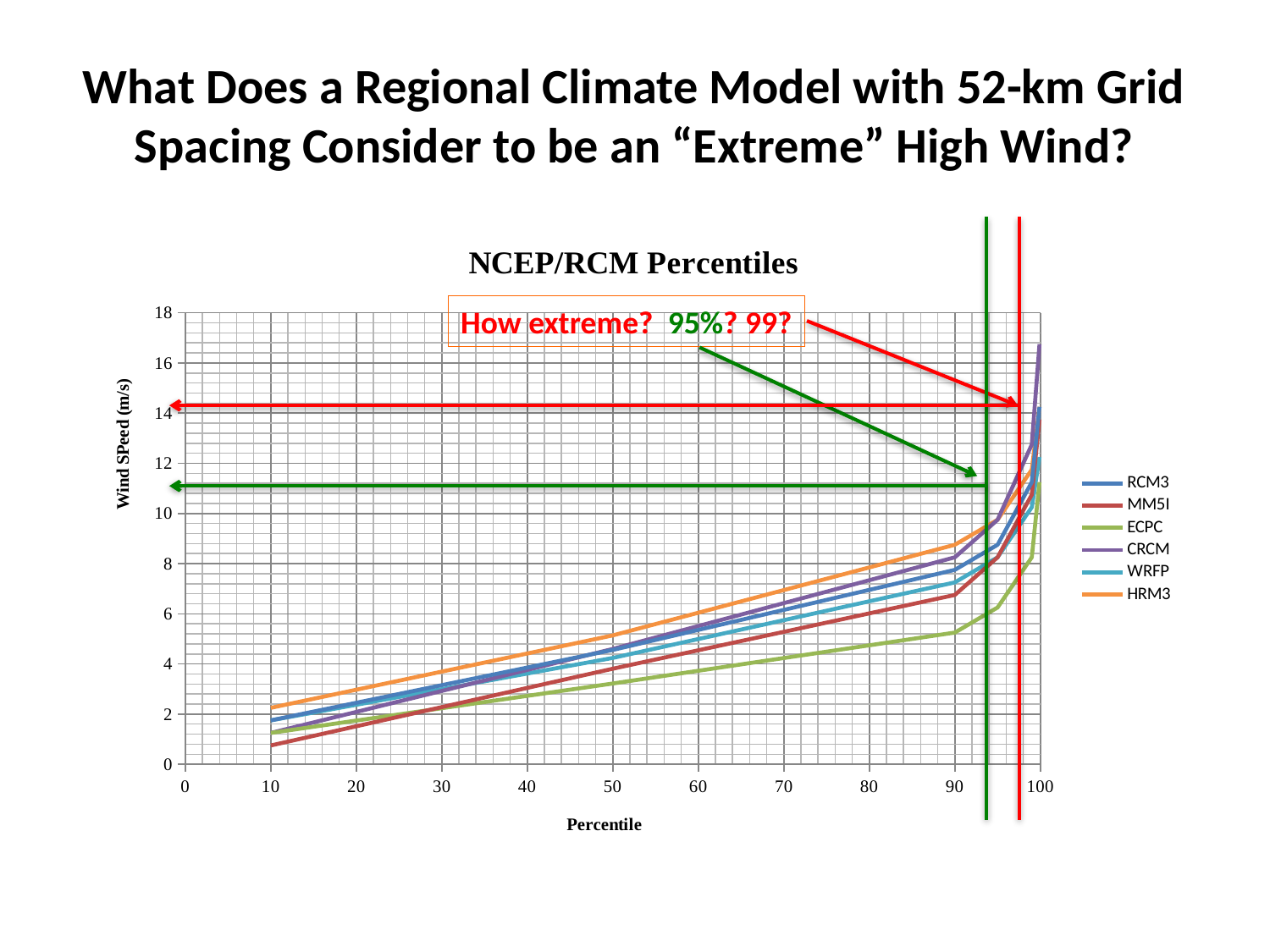
Which series has the lowest wind speed at the 10th percentile? MM5I What is the title of the chart? NCEP/RCM Percentiles Do the wind speed values rise or fall as the percentile increases along the x axis? rise Which series has the lowest wind speed at the 90th percentile? ECPC What kind of chart is shown on the slide? line chart At the 50th percentile, which series has the larger wind speed, HRM3 or ECPC? HRM3 Is the wind speed for HRM3 at the 90th percentile greater or less than 6? greater How many series does the chart legend list? 6 Is the wind speed for ECPC at the 90th percentile greater or less than 6? less What is the label of the vertical axis of the chart? Wind SPeed (m/s) Is the wind speed for MM5I at the 10th percentile greater or less than 2? less Which series has the highest wind speed at the 10th percentile? HRM3